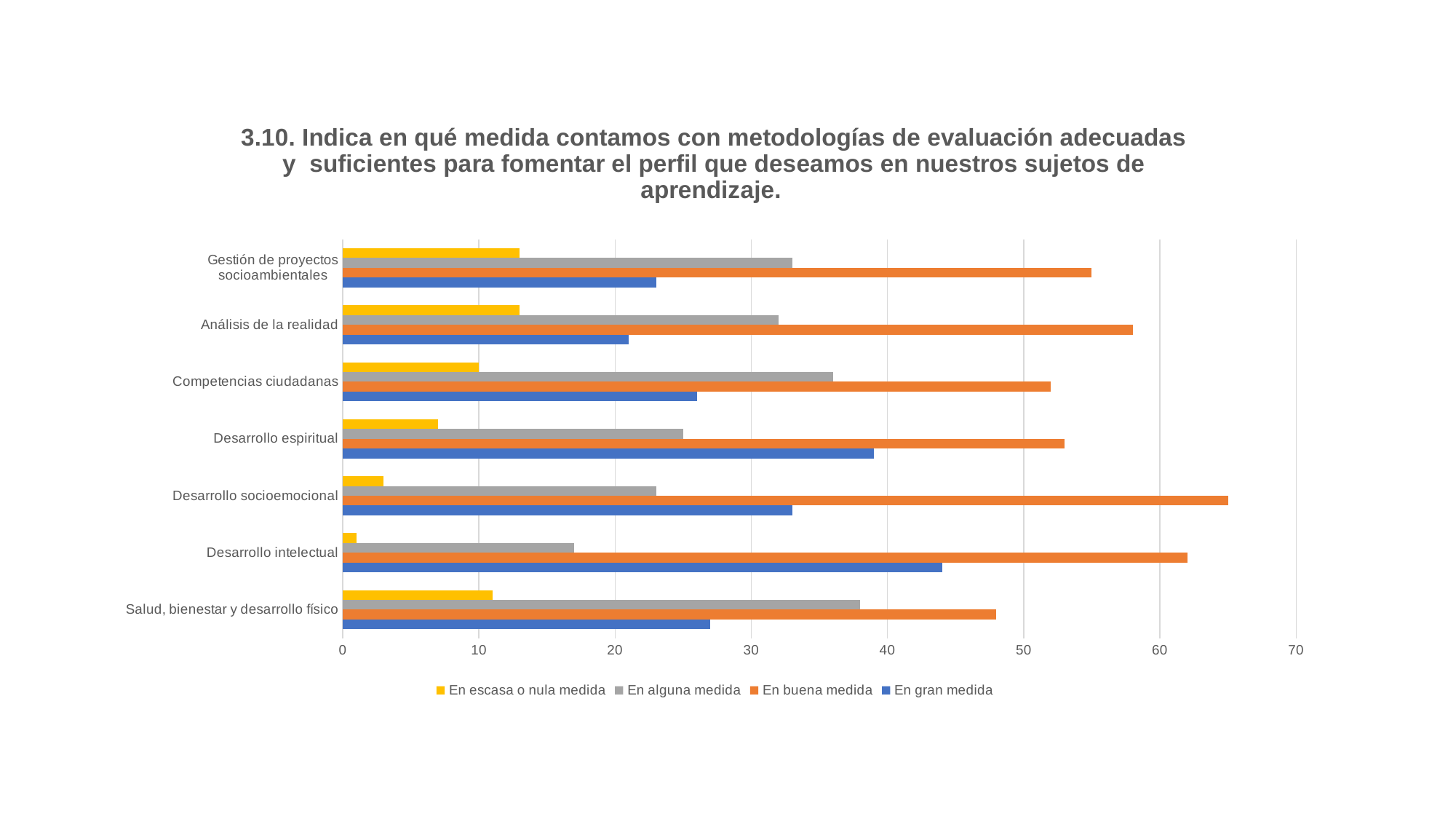
Which category has the lowest value for 'En escasa o nula medida'? Desarrollo intelectual How many categories are plotted on the vertical axis of the chart? 7 How many series does the legend list? 4 Is the 'En alguna medida' value for Competencias ciudadanas greater or less than 30? greater Which category has the highest value for 'En gran medida'? Desarrollo intelectual What colour represents the 'En gran medida' series in the legend? Blue Is the 'En buena medida' value for Desarrollo socioemocional greater or less than 60? greater What kind of chart is shown on the slide? Bar chart Is the 'En gran medida' value for Análisis de la realidad greater or less than 30? less Which category has the highest value for 'En buena medida'? Desarrollo socioemocional Which is larger: the 'En alguna medida' value for Salud, bienestar y desarrollo físico or for Desarrollo intelectual? Salud, bienestar y desarrollo físico Which is larger: the 'En gran medida' value for Desarrollo espiritual or for Gestión de proyectos socioambientales? Desarrollo espiritual